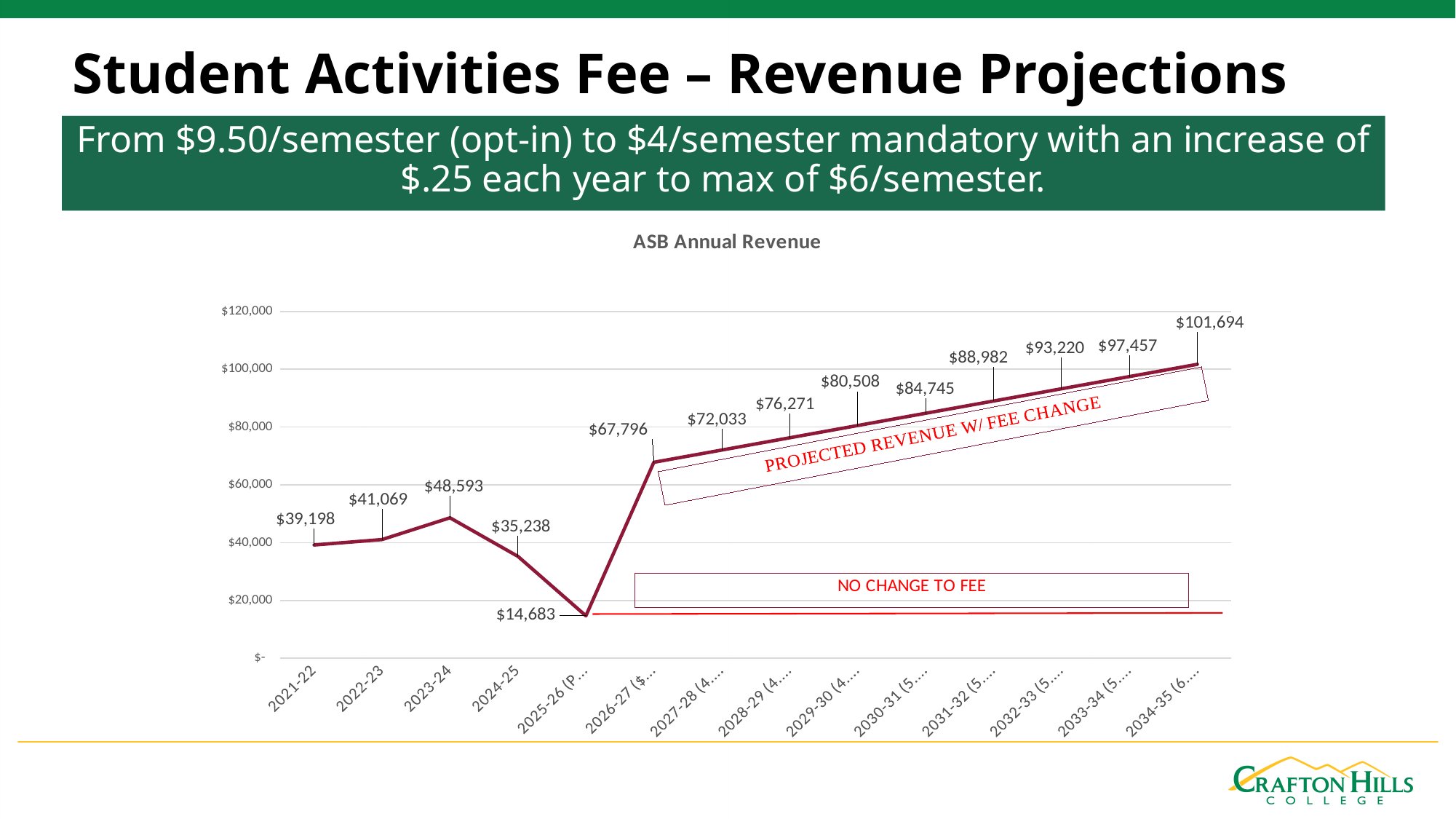
What is the title of the chart? ASB Annual Revenue Which is larger, the ASB annual revenue value for 2022-23 or for 2024-25? 2022-23 What type of chart is shown on the slide? line chart Which year has the highest ASB annual revenue value? 2034-35 What is the difference between the ASB annual revenue values for 2026-27 and 2025-26? $53,113 How many years are plotted on the x axis of the chart? 14 What is the ASB annual revenue value for 2023-24? $48,593 What is the ASB annual revenue value for 2021-22? $39,198 What is the ASB annual revenue value for 2034-35? $101,694 Which year has the lowest ASB annual revenue value? 2025-26 Do the ASB annual revenue values rise or fall from 2026-27 to 2034-35? rise Is the ASB annual revenue value for 2029-30 greater or less than $80,000? greater